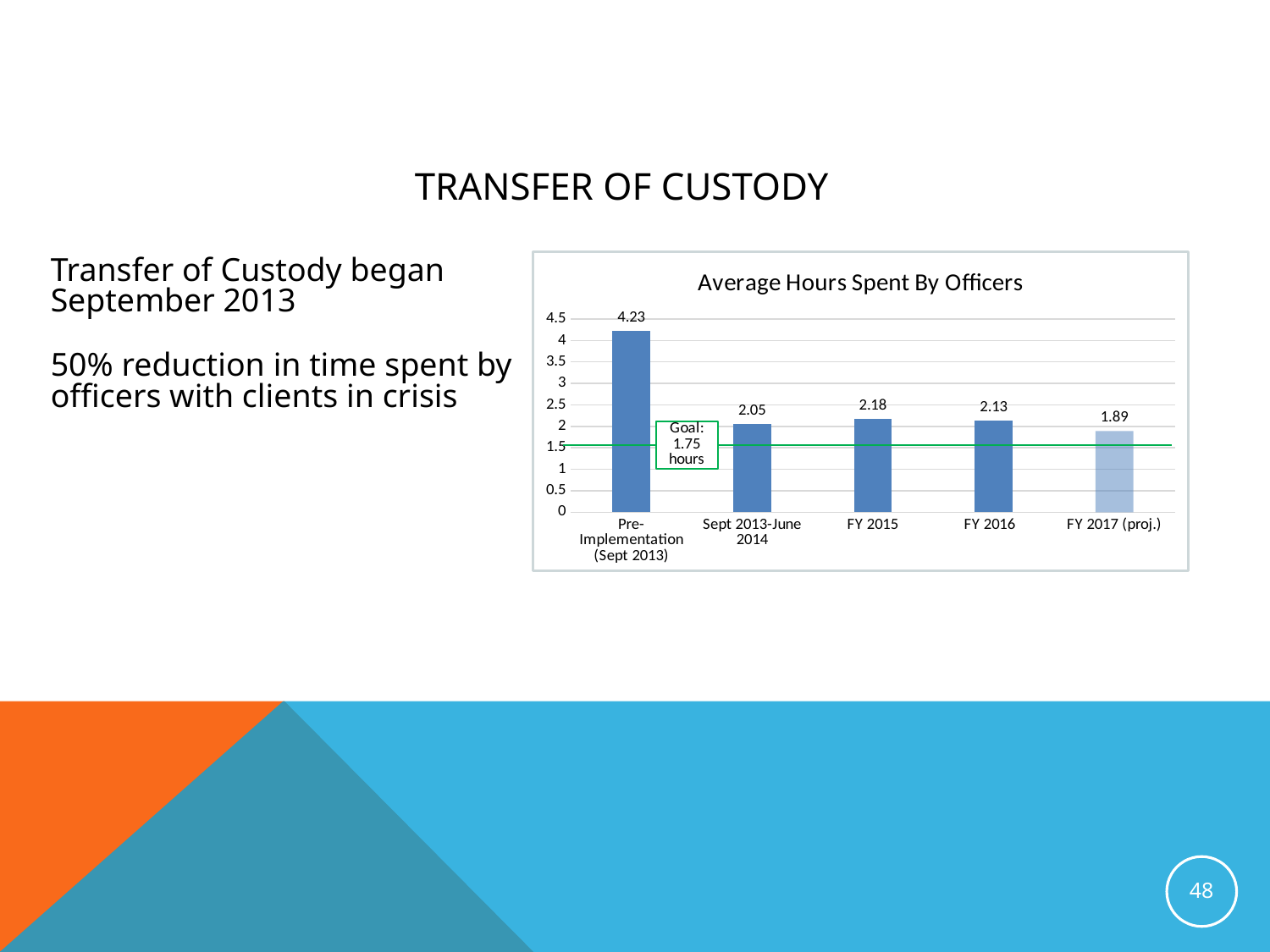
What is the average hours spent by officers for Pre-Implementation (Sept 2013)? 4.23 Which category has the highest average hours spent by officers? Pre-Implementation (Sept 2013) Is the value for FY 2016 greater or less than 2? greater What is the title of the chart? Average Hours Spent By Officers What goal value is marked by the horizontal line on the chart? 1.75 hours How many categories are shown on the x axis of the chart? 5 Which is larger, the value for FY 2015 or the value for FY 2016? FY 2015 What is the projected value for FY 2017 (proj.)? 1.89 Which category has the lowest average hours spent by officers? FY 2017 (proj.) What kind of chart is shown on the slide? Bar chart What is the difference between the Pre-Implementation (Sept 2013) value and the Sept 2013-June 2014 value? 2.18 What is the value for FY 2015? 2.18